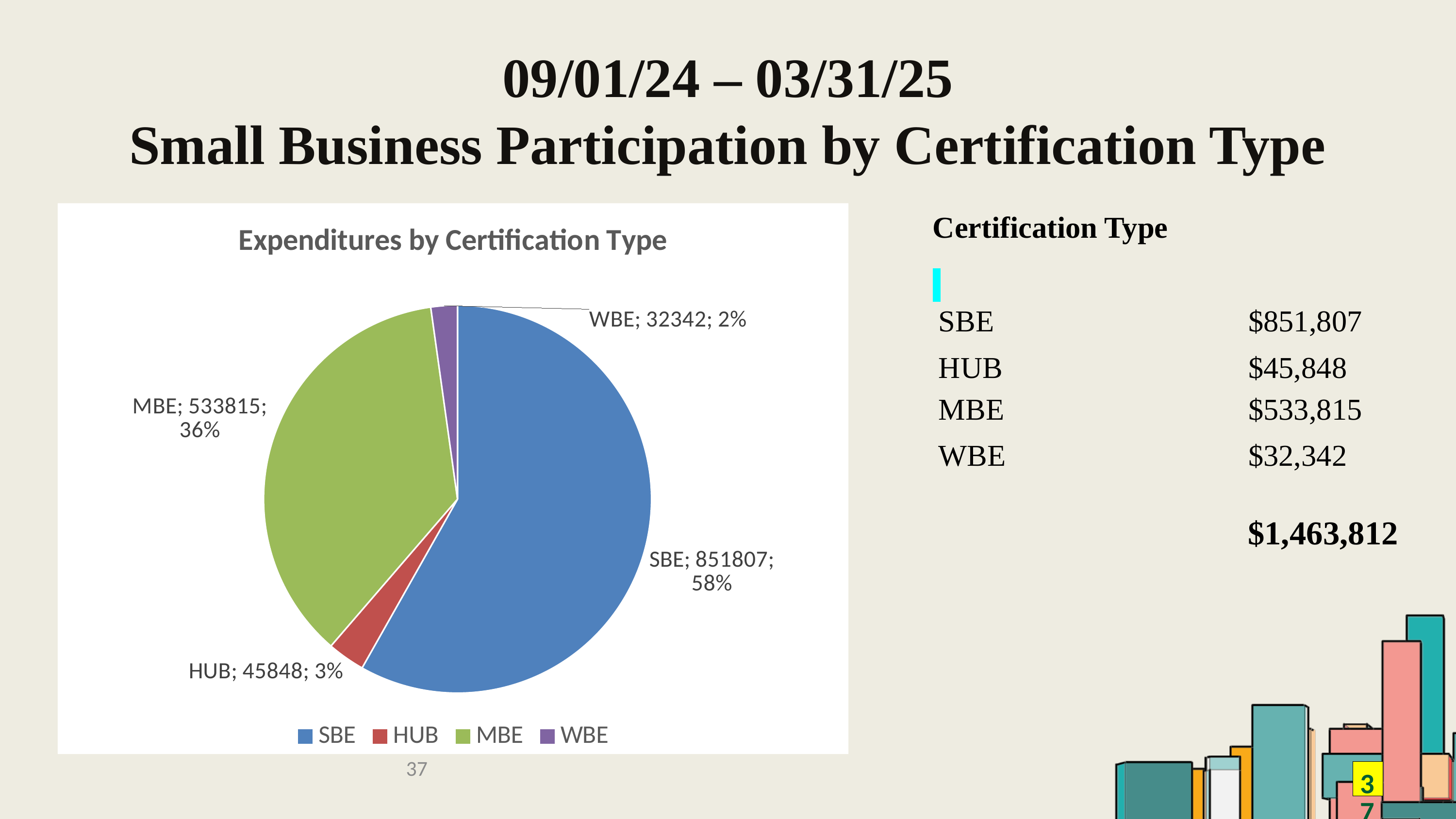
What is the difference between the SBE and MBE values? 317992 What kind of chart is shown on the slide? pie chart Which certification type has the smallest slice of the pie? WBE What share of the pie does HUB represent? 3% Which certification type has the largest slice of the pie? SBE What is the title of the chart? Expenditures by Certification Type What is the value for MBE in the pie chart? 533815 What is the value for SBE in the pie chart? 851807 What is the value for HUB in the pie chart? 45848 What share of the pie does MBE represent? 36% How many categories does the legend list? 4 What is the value for WBE in the pie chart? 32342